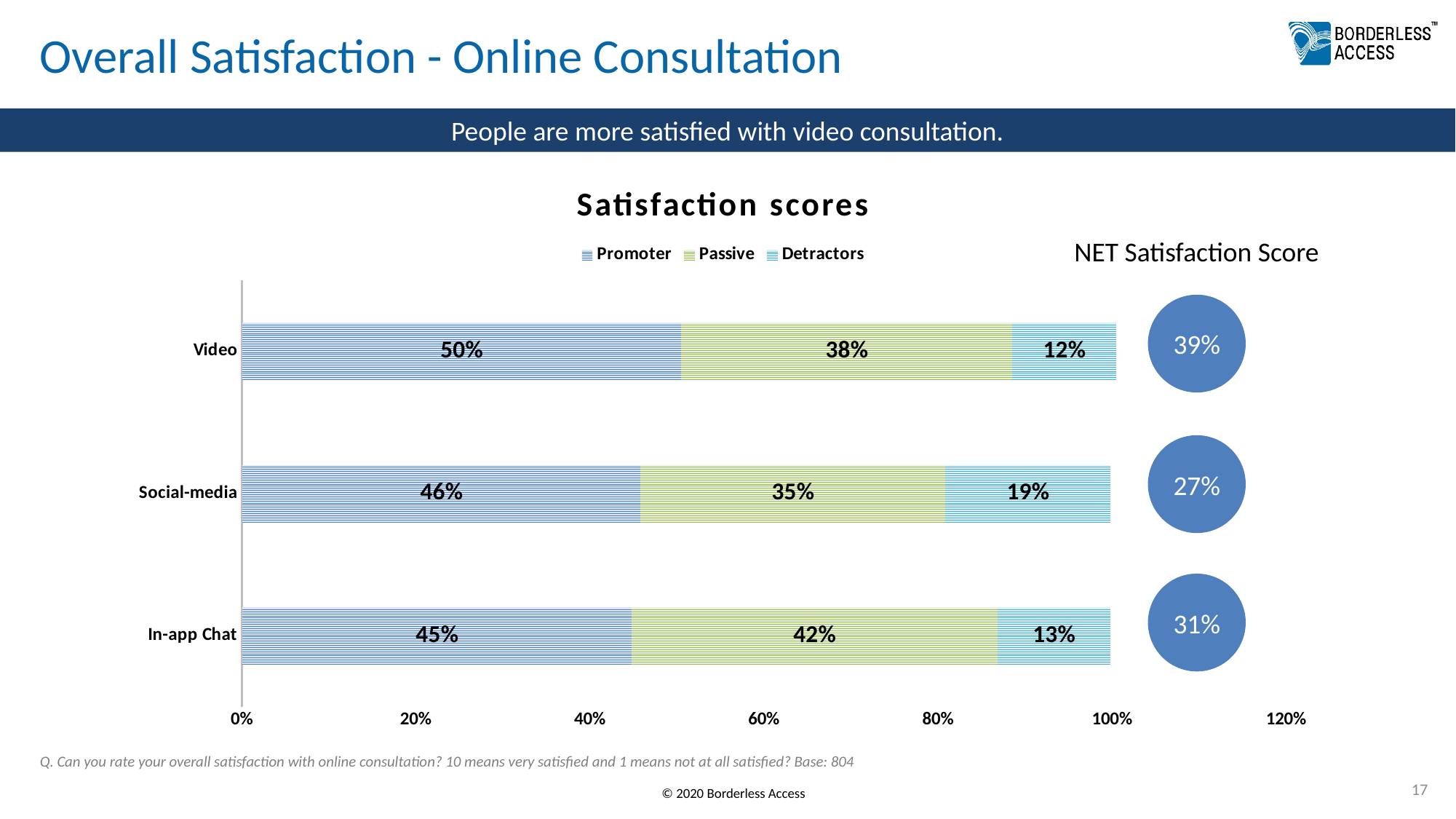
How many categories are shown in the Satisfaction scores chart? 3 What is the difference between the Detractors values for Social-media and Video in the Satisfaction scores chart? 7% What is the Detractors value for Social-media in the Satisfaction scores chart? 19% What is the total of the stacked bar for Social-media in the Satisfaction scores chart? 100% What kind of chart is the Satisfaction scores chart? Stacked bar chart What is the Passive value for In-app Chat in the Satisfaction scores chart? 42% How many series does the legend of the Satisfaction scores chart list? 3 Which category has the highest Promoter value in the Satisfaction scores chart? Video What is the NET Satisfaction Score shown for In-app Chat? 31% Which is larger in the Satisfaction scores chart: the Passive value for In-app Chat or the Passive value for Social-media? In-app Chat Which category has the lowest Detractors value in the Satisfaction scores chart? Video What is the Promoter value for Video in the Satisfaction scores chart? 50%